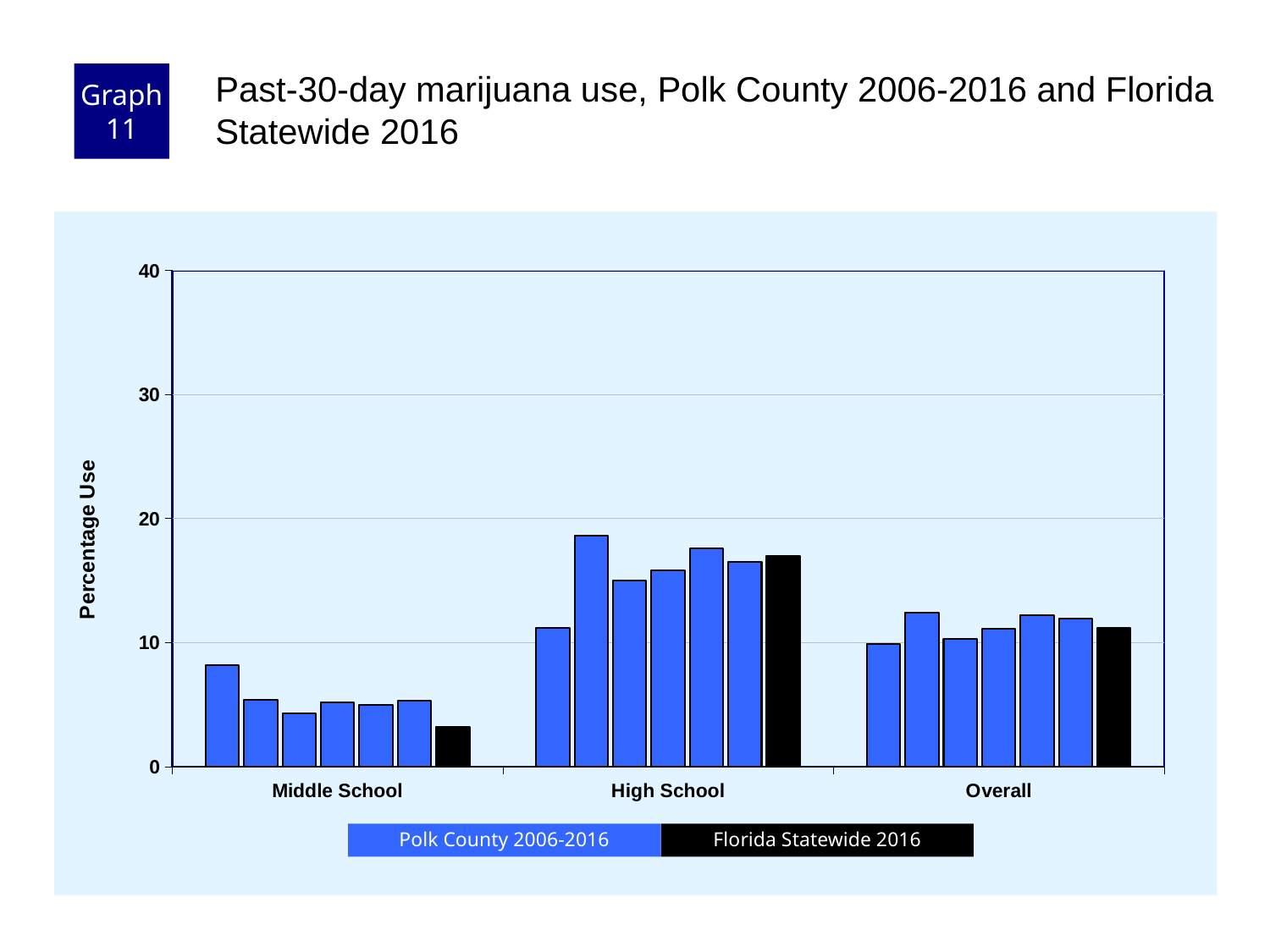
Which category has the highest bars overall? High School Which series is shown in black in the legend? Florida Statewide 2016 How many categories are shown on the x axis? 3 What kind of chart is shown on the slide? Bar chart Which category has the lowest bars overall? Middle School How many series does the legend list? 2 Is the Florida Statewide 2016 value for High School greater or less than 20? less What is the label of the y axis? Percentage Use Is the Florida Statewide 2016 value for High School greater or less than 10? greater Are all the Polk County 2006-2016 bars for Middle School greater or less than 10? less Which is larger, the Florida Statewide 2016 value for High School or for Overall? High School